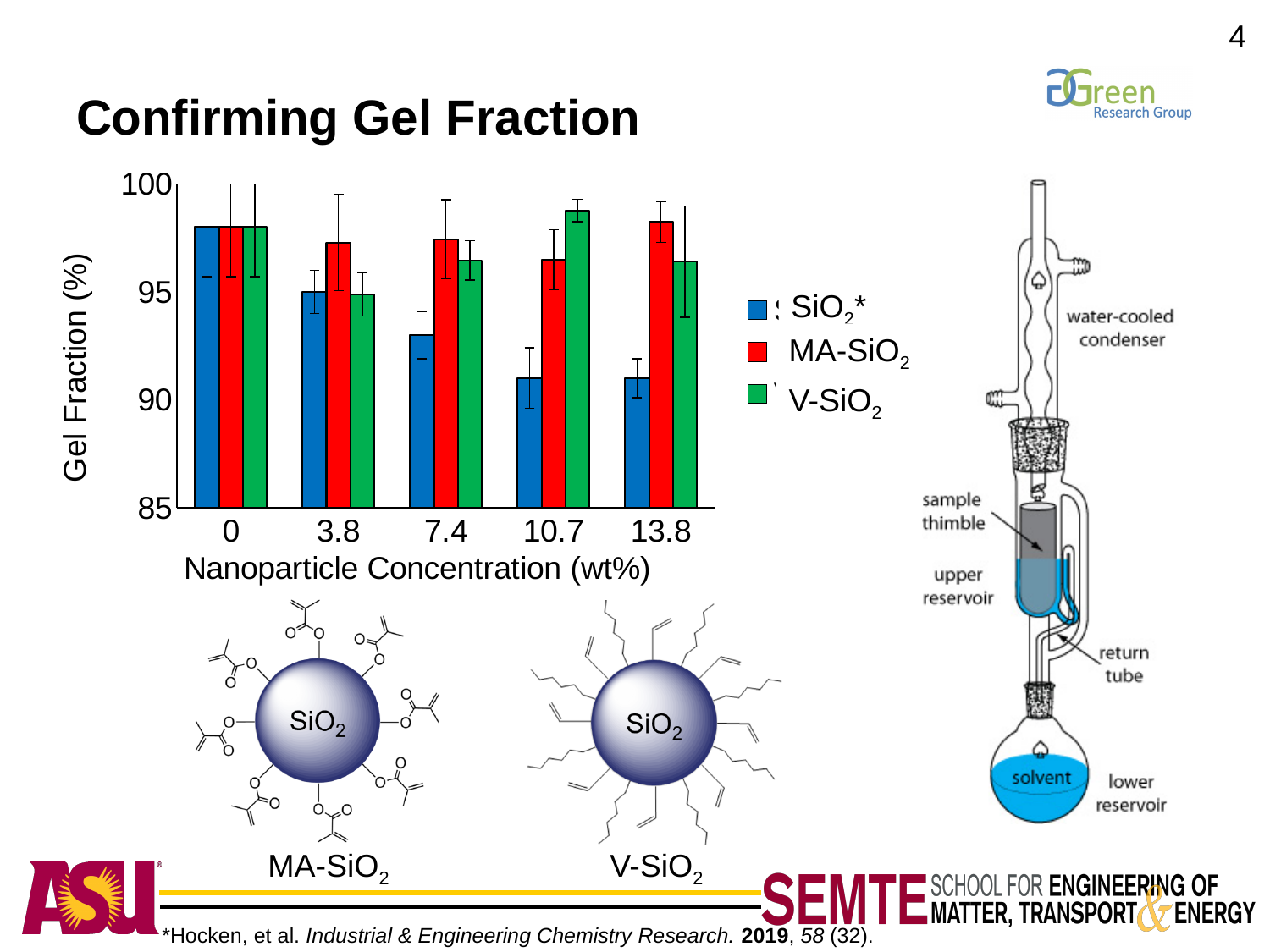
Is the gel fraction for SiO2* at 7.4 wt% greater or less than 95? less How many series does the chart's legend list? 3 At 13.8 wt%, which has the higher gel fraction: MA-SiO2 or V-SiO2? MA-SiO2 Is the gel fraction for MA-SiO2 at 7.4 wt% greater or less than 95? greater What kind of chart is shown on the slide? bar chart How many nanoparticle concentration categories are shown on the x axis of the chart? 5 Is the gel fraction for SiO2* at 13.8 wt% greater or less than 95? less Does the gel fraction for SiO2* rise or fall as nanoparticle concentration increases? fall At 10.7 wt%, which has the higher gel fraction: SiO2* or V-SiO2? V-SiO2 At which nanoparticle concentration is the gel fraction for SiO2* highest? 0 What is the label of the chart's y axis? Gel Fraction (%)